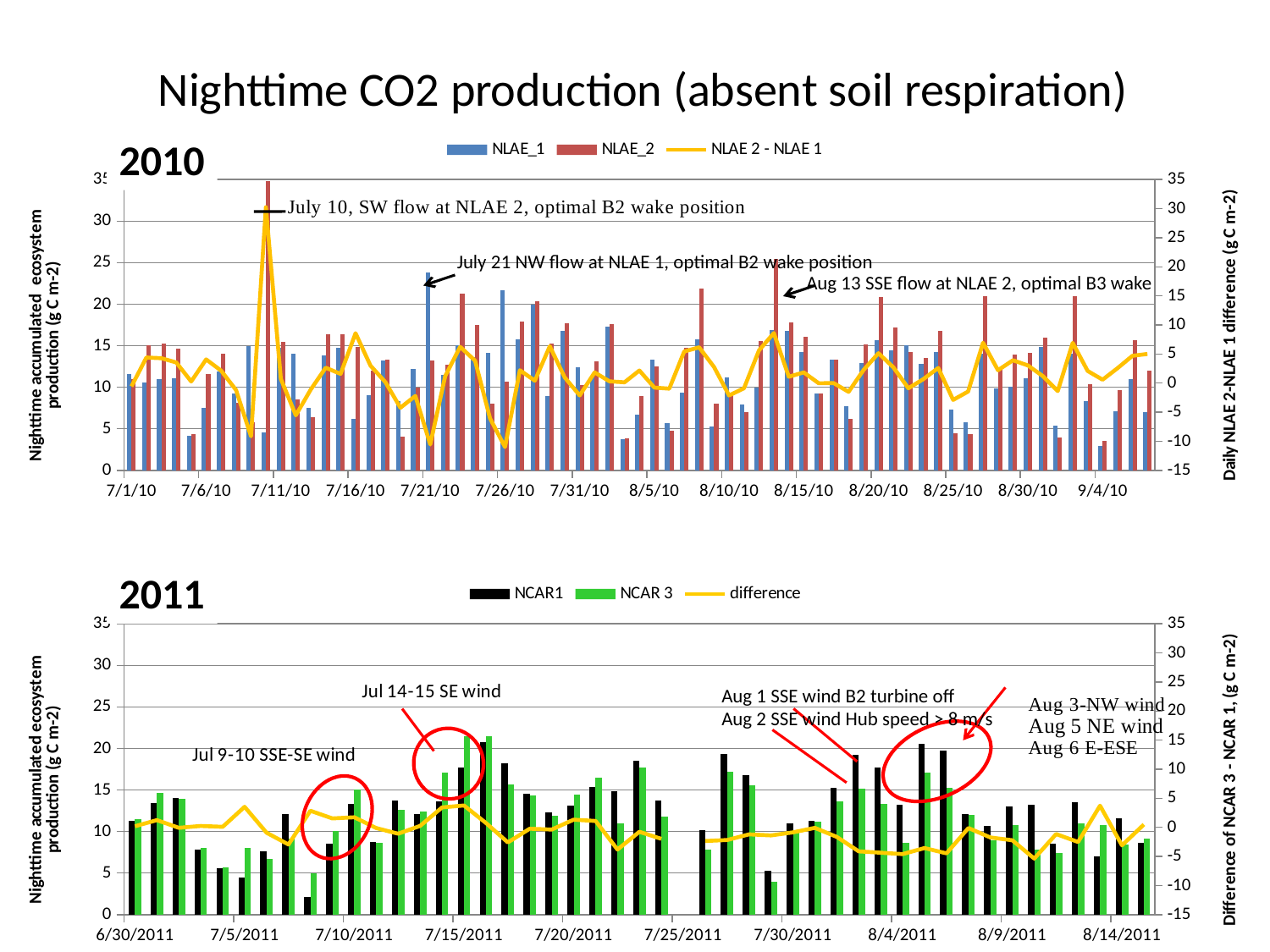
How many series does the legend of the 2010 chart list? 3 In the 2011 chart, is the NCAR1 value on 8/5/2011 greater or less than 15? greater In the 2010 chart, is the NLAE_1 value on 7/21/10 greater or less than 20? greater In the 2010 chart, which series is plotted as a line rather than bars? NLAE 2 - NLAE 1 What kind of chart is the 2010 chart at the top of the slide? bar chart with a line In the 2011 chart, is the NCAR1 value on 7/9/2011 greater or less than 5? greater How many series does the legend of the 2011 chart list? 3 What is the label of the right-hand vertical axis of the 2011 chart? Difference of NCAR 3 - NCAR 1, (g C m-2)